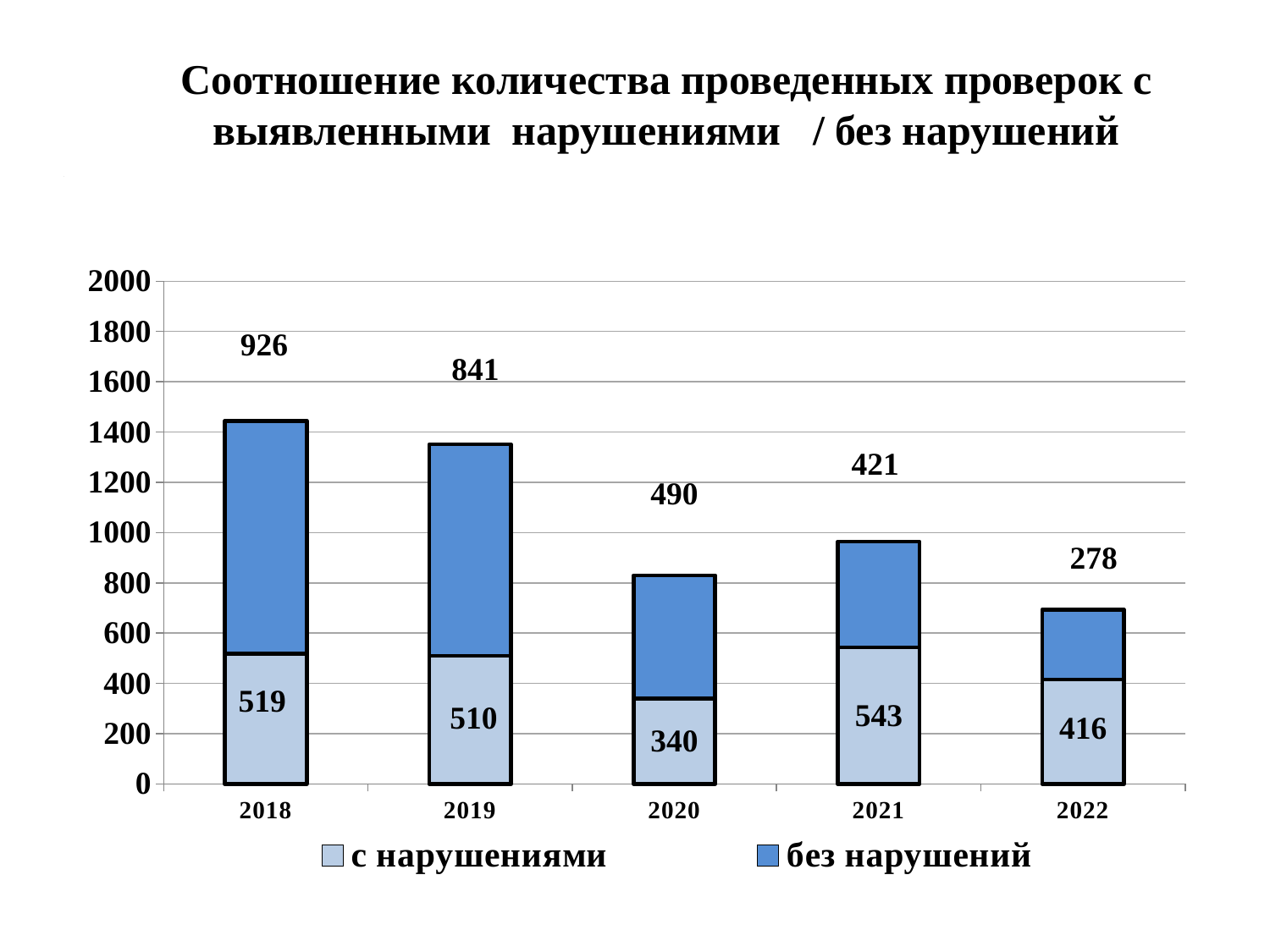
What is the value for "без нарушений" in 2022? 278 How many years are shown on the x axis? 5 In which year is the value for "без нарушений" highest? 2018 In which year is the value for "с нарушениями" lowest? 2020 Which is larger in 2021: "с нарушениями" or "без нарушений"? с нарушениями What is the value for "с нарушениями" in 2018? 519 What kind of chart is shown on the slide? Stacked bar chart What is the total of the stacked bar for 2022? 694 What is the total of the stacked bar for 2020? 830 What is the value for "без нарушений" in 2020? 490 How many series does the legend list? 2 What is the difference between the "без нарушений" values for 2018 and 2019? 85